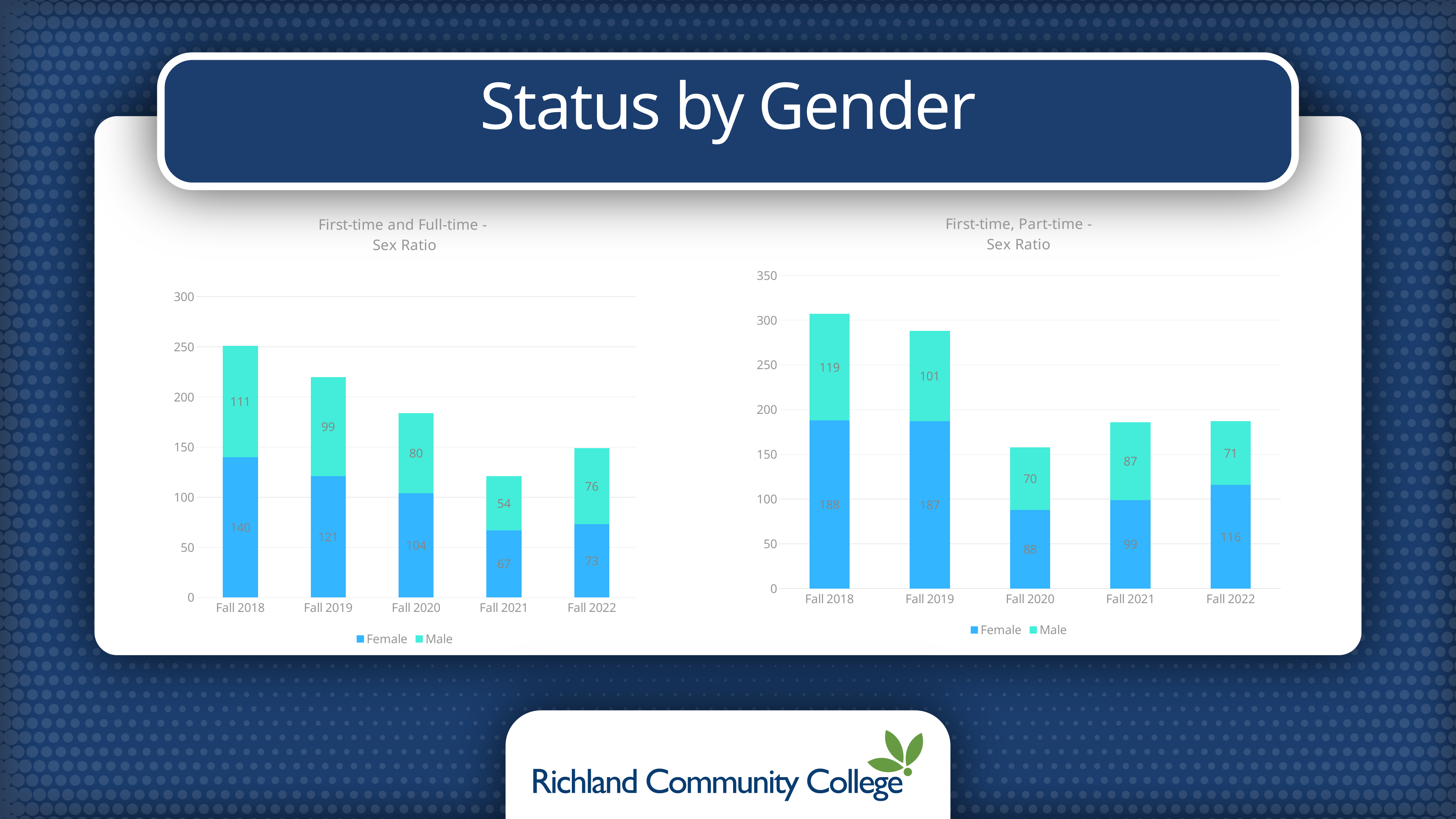
In the 'First-time and Full-time - Sex Ratio' chart, which Fall term has the lowest Female value? Fall 2021 In the 'First-time, Part-time - Sex Ratio' chart, what is the Male value for Fall 2019? 101 How many series does the legend of the 'First-time, Part-time - Sex Ratio' chart list? 2 In the 'First-time and Full-time - Sex Ratio' chart, what is the total of the stacked bar for Fall 2020? 184 In the 'First-time and Full-time - Sex Ratio' chart, what is the Female value for Fall 2018? 140 In the 'First-time, Part-time - Sex Ratio' chart, is the Female value for Fall 2020 larger or the Male value for Fall 2020? Female In the 'First-time and Full-time - Sex Ratio' chart, does the Female value rise or fall from Fall 2018 to Fall 2021? Fall What kind of chart is the 'First-time and Full-time - Sex Ratio' chart? Stacked bar chart In the 'First-time and Full-time - Sex Ratio' chart, what is the difference between the Female and Male values for Fall 2019? 22 In the 'First-time, Part-time - Sex Ratio' chart, what is the total of the stacked bar for Fall 2022? 187 How many Fall terms are shown on the x axis of the 'First-time and Full-time - Sex Ratio' chart? 5 In the 'First-time, Part-time - Sex Ratio' chart, which Fall term has the highest Male value? Fall 2018